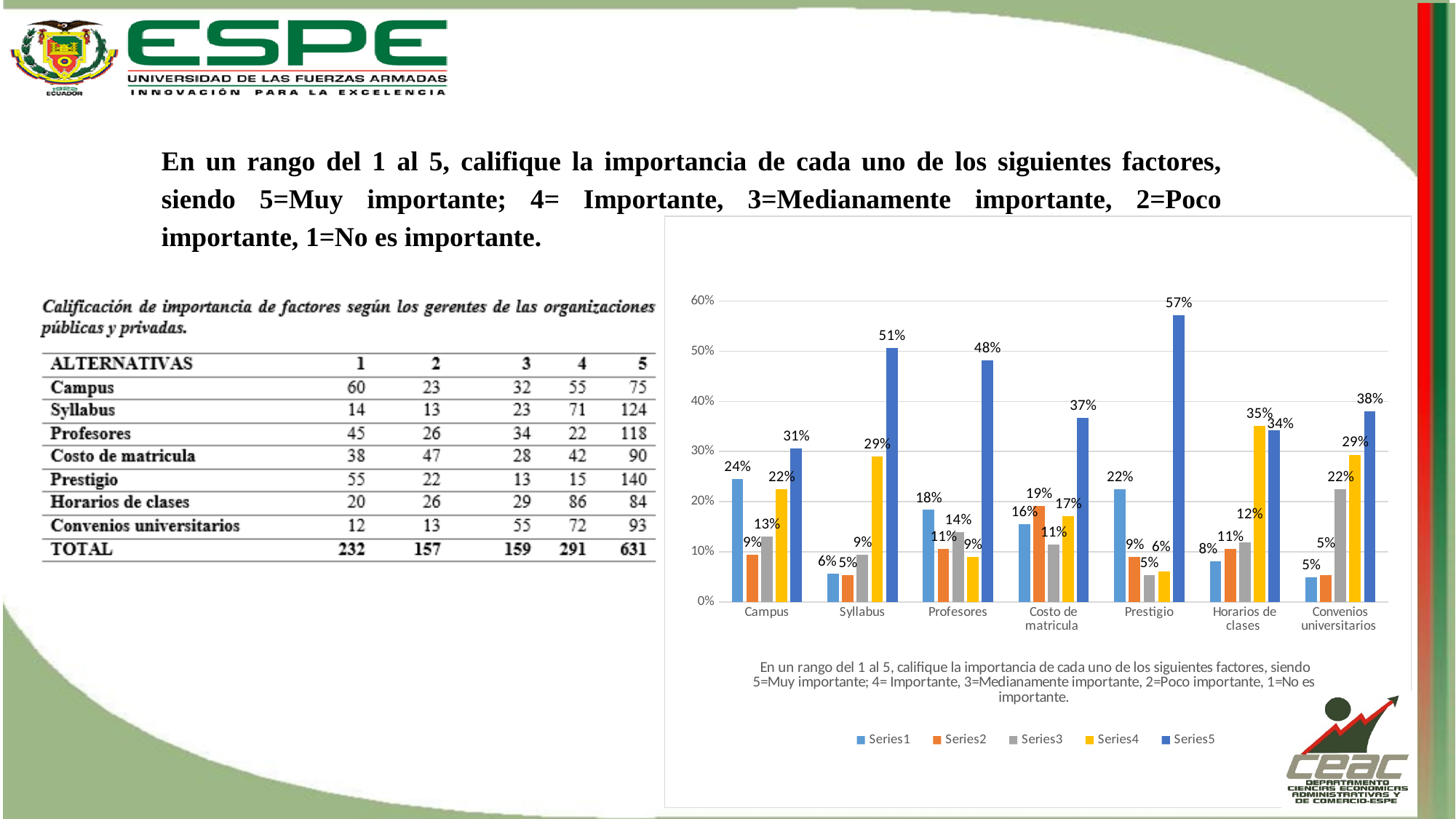
What is the Series1 value for Campus? 24% How many categories are shown on the x axis of the chart? 7 Is the Series5 value for Costo de matricula greater or less than 30%? greater Which category has the highest Series5 value? Prestigio Which is larger: the Series4 value for Convenios universitarios or the Series4 value for Campus? Convenios universitarios What is the Series5 value for Prestigio? 57% Which category has the lowest Series5 value? Campus What is the difference between the Series5 value for Syllabus and the Series5 value for Profesores? 3% How many series does the chart's legend list? 5 What type of chart is shown on the slide? bar chart What is the Series4 value for Horarios de clases? 35% What colour are the Series5 bars in the chart? dark blue